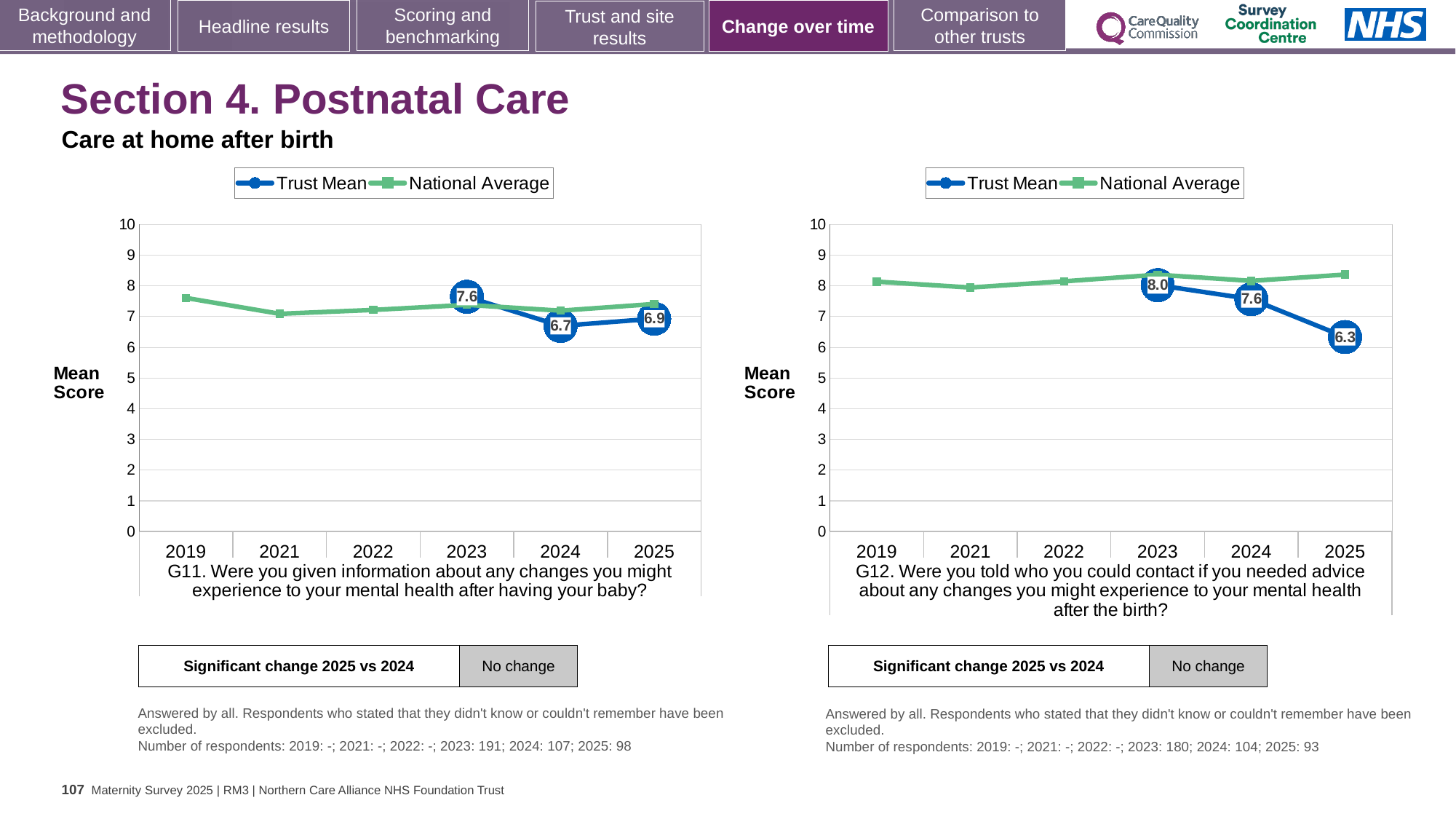
What type of chart is the G12 chart on the right? line chart In the G11 chart on the left, which year has the highest labelled Trust Mean? 2023 In the G12 chart on the right, what is the Trust Mean for 2025? 6.3 In the G12 chart on the right, is the National Average for 2019 greater or less than 7? greater In the G12 chart on the right, does the Trust Mean rise or fall from 2023 to 2025? fall In the G11 chart on the left, what is the difference between the Trust Mean for 2023 and the Trust Mean for 2024? 0.9 In the G12 chart on the right, which year has the lowest labelled Trust Mean? 2025 In the G11 chart on the left, what is the Trust Mean for 2025? 6.9 In the G12 chart on the right, what is the Trust Mean for 2023? 8.0 In the G11 chart on the left, what is the Trust Mean for 2023? 7.6 In the G12 chart on the right, what is the difference between the Trust Mean for 2024 and the Trust Mean for 2025? 1.3 How many years are shown on the x axis of the G11 chart on the left? 6